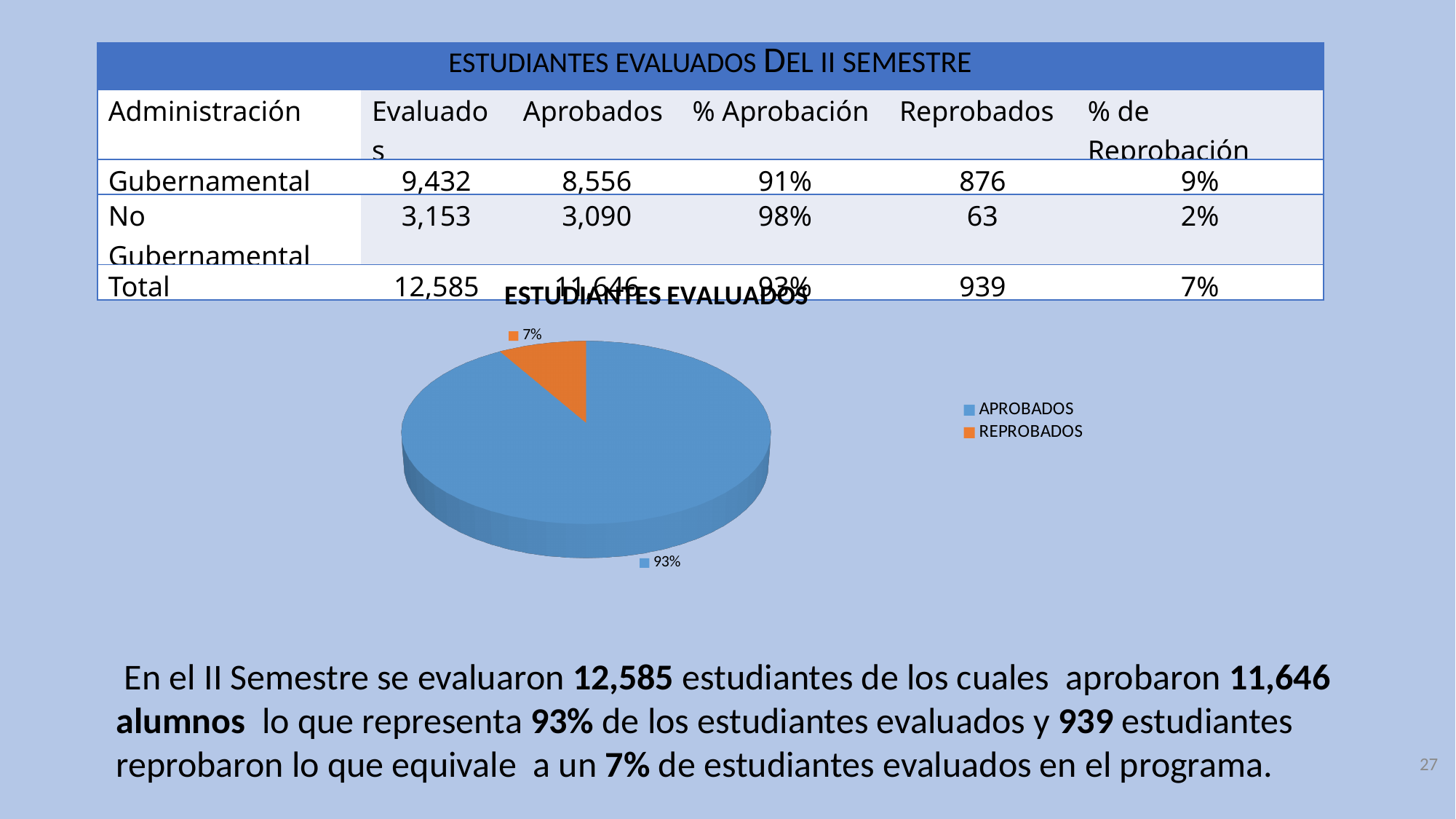
Is the share for APROBADOS greater or less than 50%? greater What colour is the REPROBADOS slice in the pie chart? orange What share of the pie does APROBADOS represent? 93% What share of the pie does REPROBADOS represent? 7% How many slices does the pie chart have? 2 How many entries does the pie chart's legend list? 2 Which slice of the pie chart is the largest? APROBADOS What kind of chart is shown on the slide? pie chart Which is larger in the pie chart, APROBADOS or REPROBADOS? APROBADOS What is the title of the pie chart? ESTUDIANTES EVALUADOS What is the difference in percentage points between the APROBADOS and REPROBADOS slices? 86% Which slice of the pie chart is the smallest? REPROBADOS